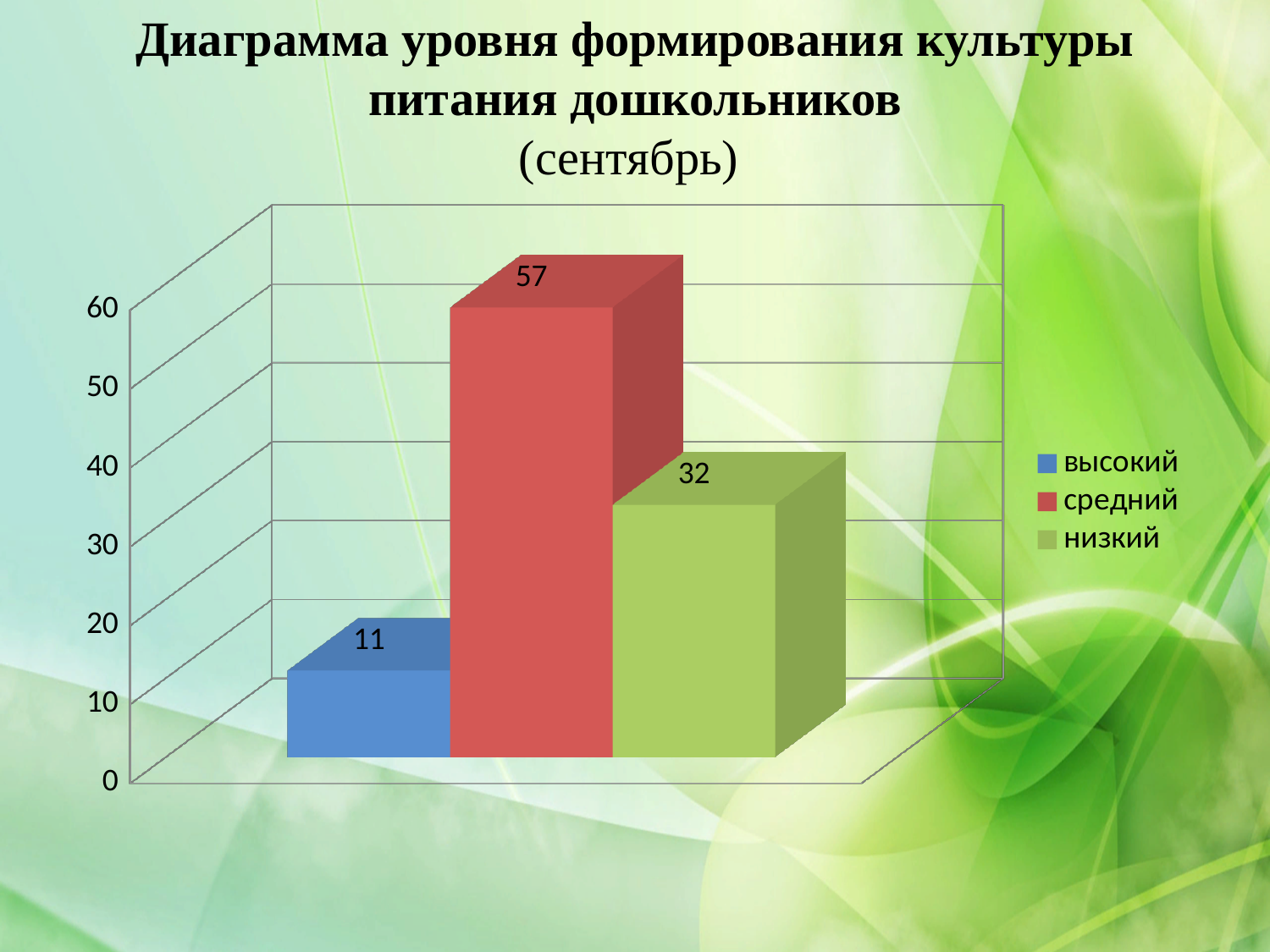
Which is larger, the value for низкий or the value for высокий? низкий What is the value for низкий? 32 What kind of chart is shown on the slide? bar chart Which category has the highest value? средний What is the difference between the values for средний and низкий? 25 How many series does the legend list? 3 Which category has the lowest value? высокий What is the value for средний? 57 Is the value for средний greater or less than 50? greater What is the difference between the values for низкий and высокий? 21 What colour is the bar for средний? red What is the value for высокий? 11